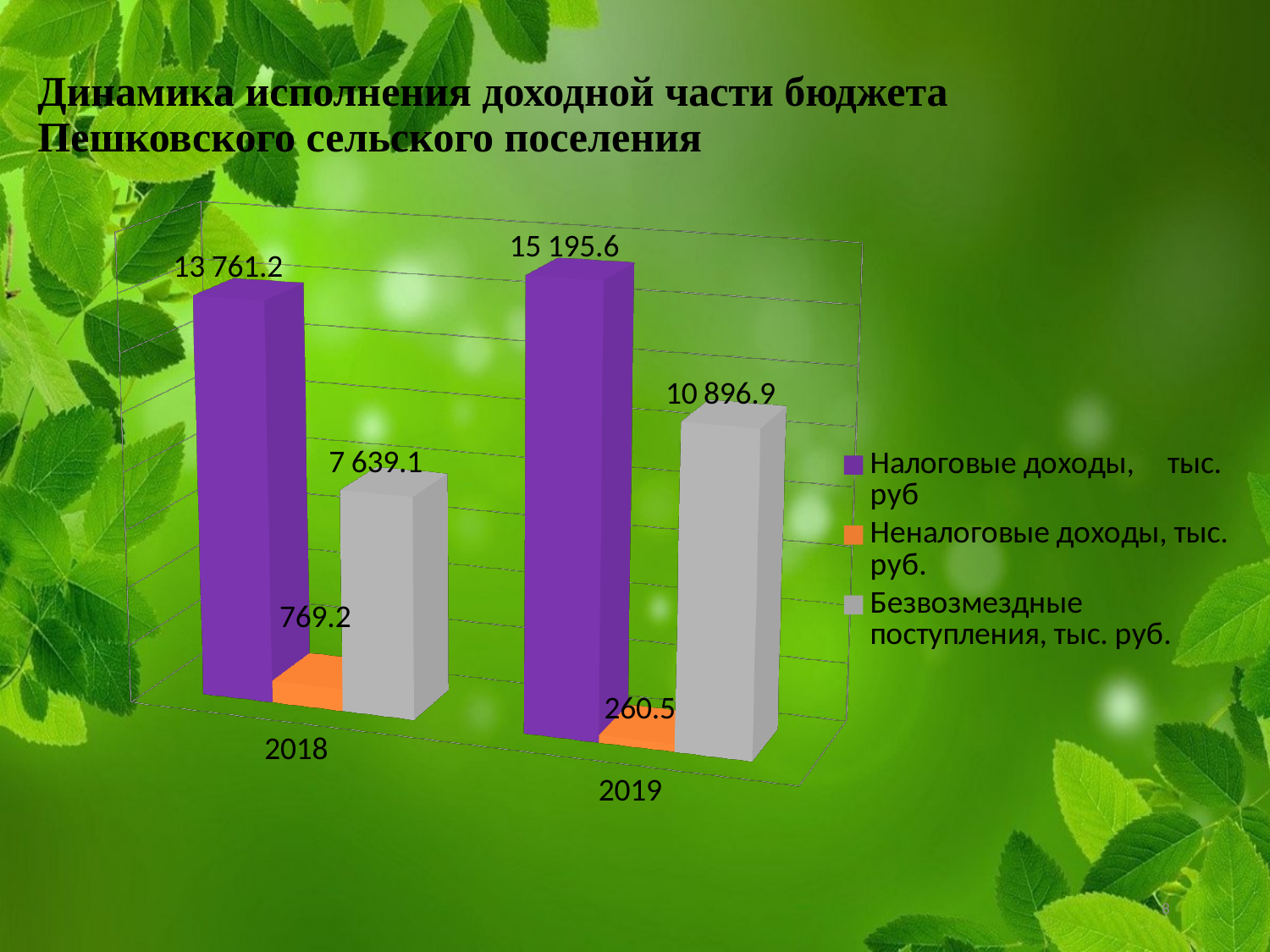
How many years are shown on the x axis? 2 What kind of chart is shown on the slide? Bar chart What is the value of Налоговые доходы for 2019? 15 195.6 By how much did Налоговые доходы increase from 2018 to 2019? 1 434.4 What is the value of Безвозмездные поступления for 2018? 7 639.1 What is the value of Неналоговые доходы for 2018? 769.2 Which year has the larger value for Неналоговые доходы, 2018 or 2019? 2018 How many series does the legend list? 3 Which series has the lowest value in 2018? Неналоговые доходы What is the value of Неналоговые доходы for 2019? 260.5 Which series has the highest value in 2019? Налоговые доходы What is the difference between Безвозмездные поступления in 2019 and 2018? 3 257.8